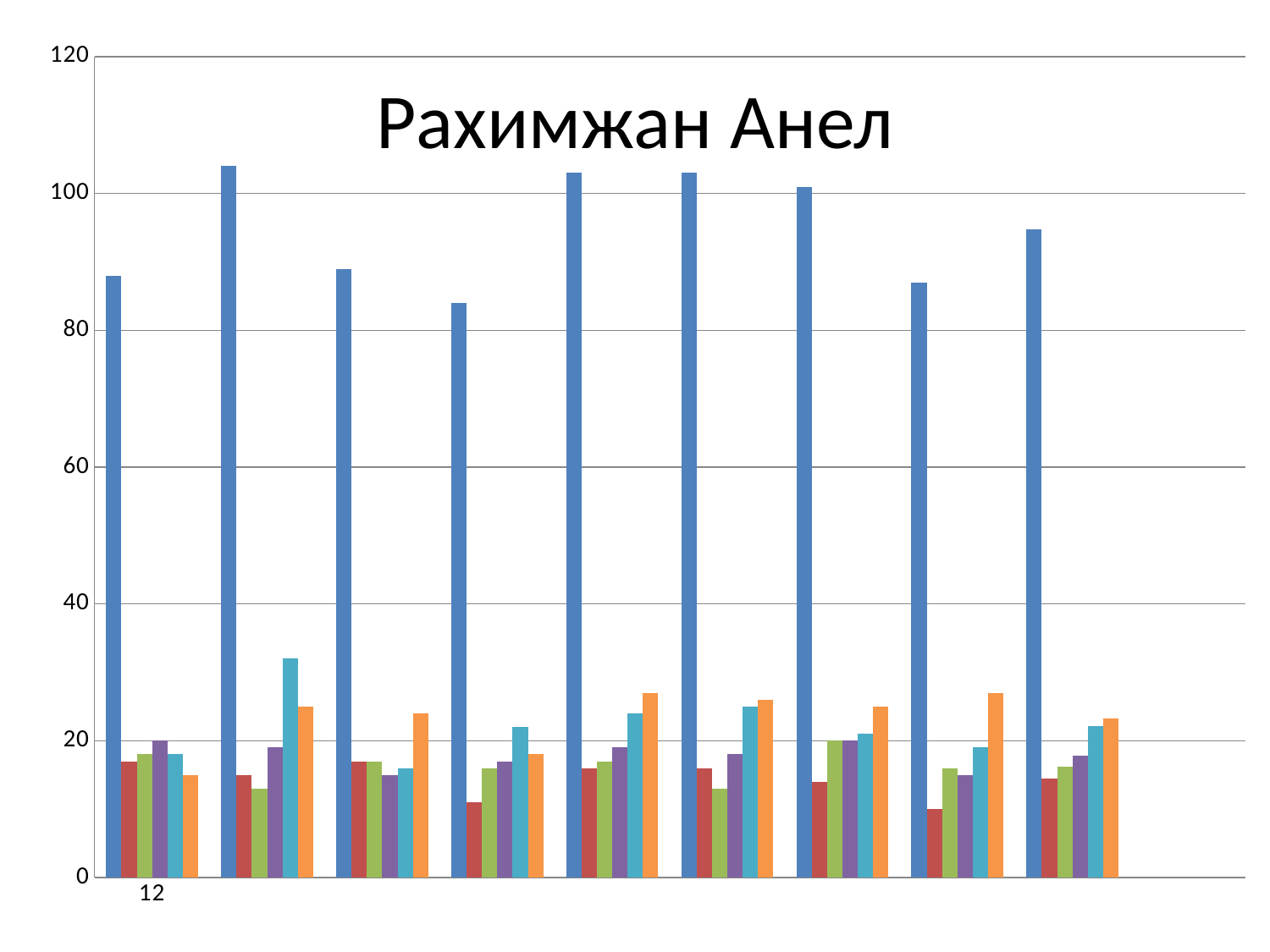
Is the value of the blue bar for the category labelled 12 greater or less than 80? greater Is the value of the blue bar for the category labelled 12 greater or less than 100? less What is the title of the chart? Рахимжан Анел In the category labelled 12, which is larger: the purple bar or the orange bar? the purple bar How many groups of bars are plotted in the chart? 9 In the category labelled 12, which is larger: the blue bar or the red bar? the blue bar Which colour of bar is the tallest in every group of the chart? blue Is the value of the blue bar in the second group greater or less than 100? greater What kind of chart is shown on the slide? bar chart How many bars are there in each group of the chart? 6